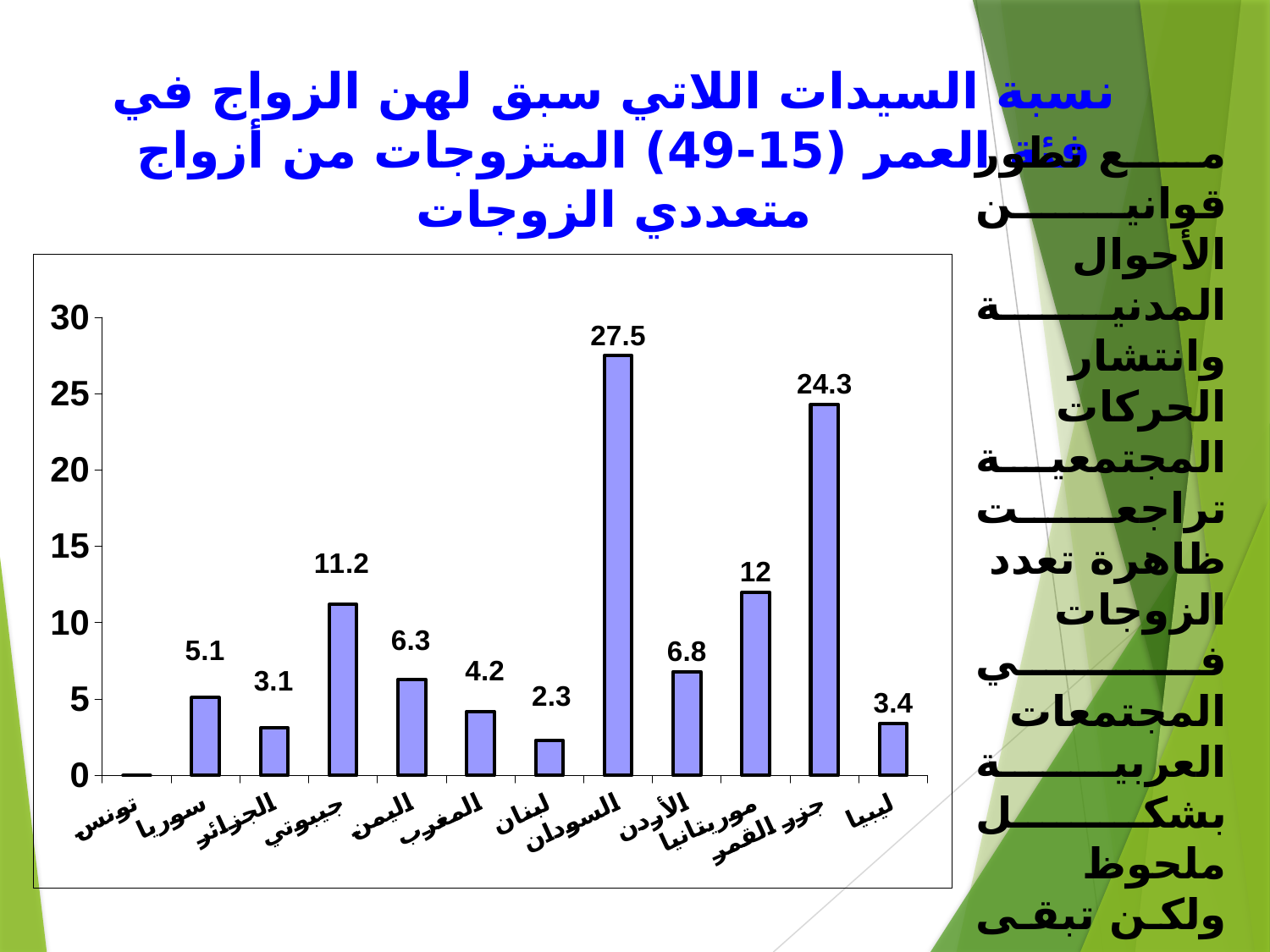
What is the difference between the values for سوريا and الجزائر? 2 Is the value for جزر القمر greater or less than 20? greater What is the value for جيبوتي (Djibouti)? 11.2 Which country has the highest value? السودان Which is larger, the value for الأردن or the value for اليمن? الأردن What is the value for السودان (Sudan)? 27.5 What is the difference between the values for السودان and جزر القمر? 3.2 How many countries are shown on the x axis? 12 What kind of chart is shown? bar chart What colour are the bars in the chart? light purple/blue What is the value for موريتانيا (Mauritania)? 12 What is the value for ليبيا (Libya)? 3.4